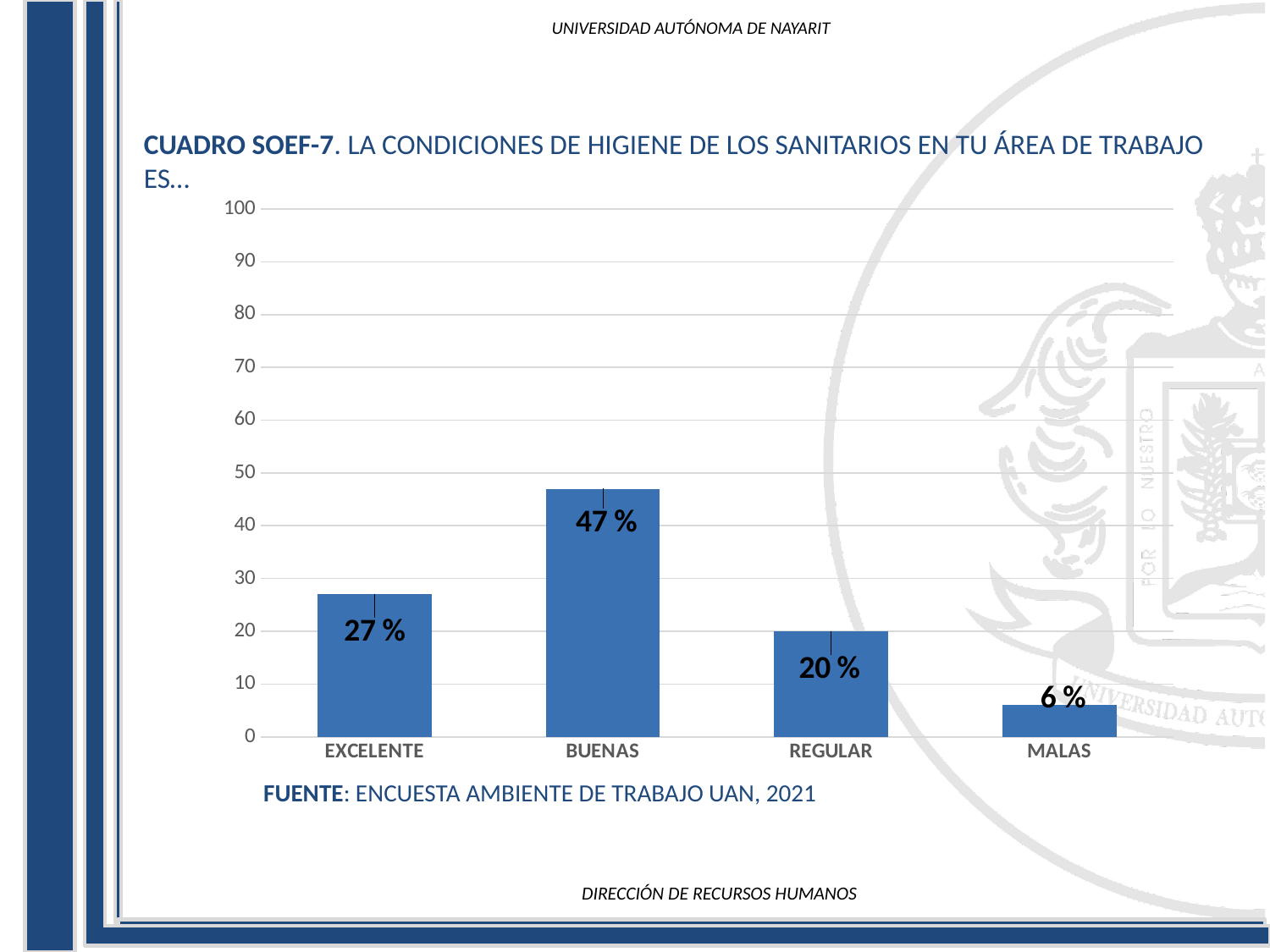
What is the source cited below the chart? ENCUESTA AMBIENTE DE TRABAJO UAN, 2021 What is the difference between the values for BUENAS and EXCELENTE? 20 % Which category has the highest value? BUENAS What is the value for REGULAR? 20 % What kind of chart is shown on the slide? Bar chart How many categories are shown on the x axis? 4 Which category has the lowest value? MALAS What is the value for MALAS? 6 % What is the value for BUENAS? 47 % What is the value for EXCELENTE? 27 % Which is larger, the value for EXCELENTE or the value for REGULAR? EXCELENTE What is the difference between the values for REGULAR and MALAS? 14 %